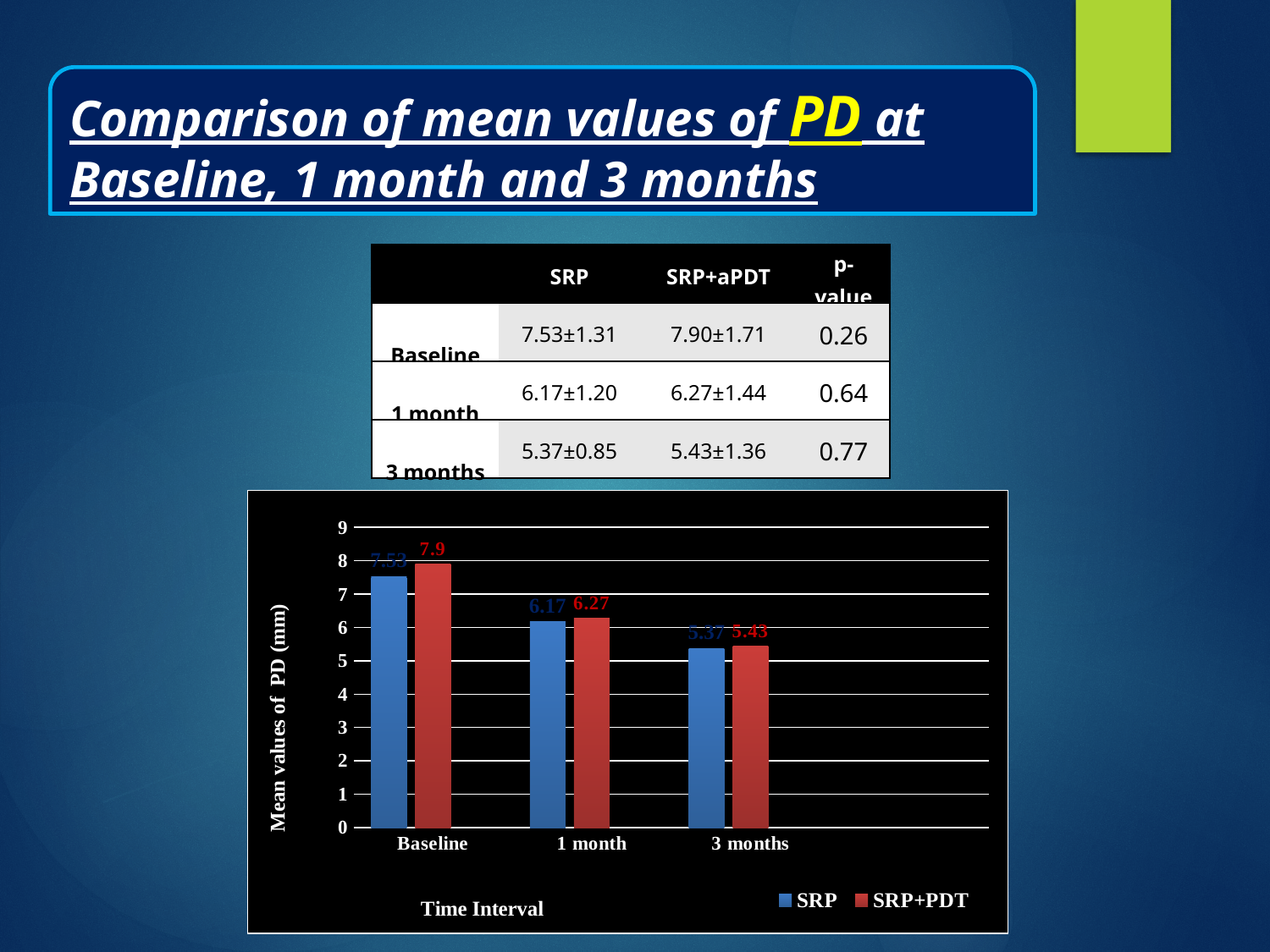
What is the value for SRP+PDT at Baseline in the chart? 7.9 What is the value for SRP+PDT at 3 months in the chart? 5.43 What is the label of the y axis of the chart? Mean values of PD (mm) What is the value for SRP at 3 months in the chart? 5.37 How many time-interval categories are shown on the x axis of the chart? 3 What is the value for SRP at 1 month in the chart? 6.17 Do the SRP values rise or fall from Baseline to 3 months along the x axis? fall How many series does the chart legend list? 2 What is the difference between the SRP+PDT value at 1 month and the SRP value at 1 month? 0.1 What type of chart is shown on the slide? bar chart At which time interval is the SRP value lowest? 3 months At which time interval is the SRP+PDT value highest? Baseline